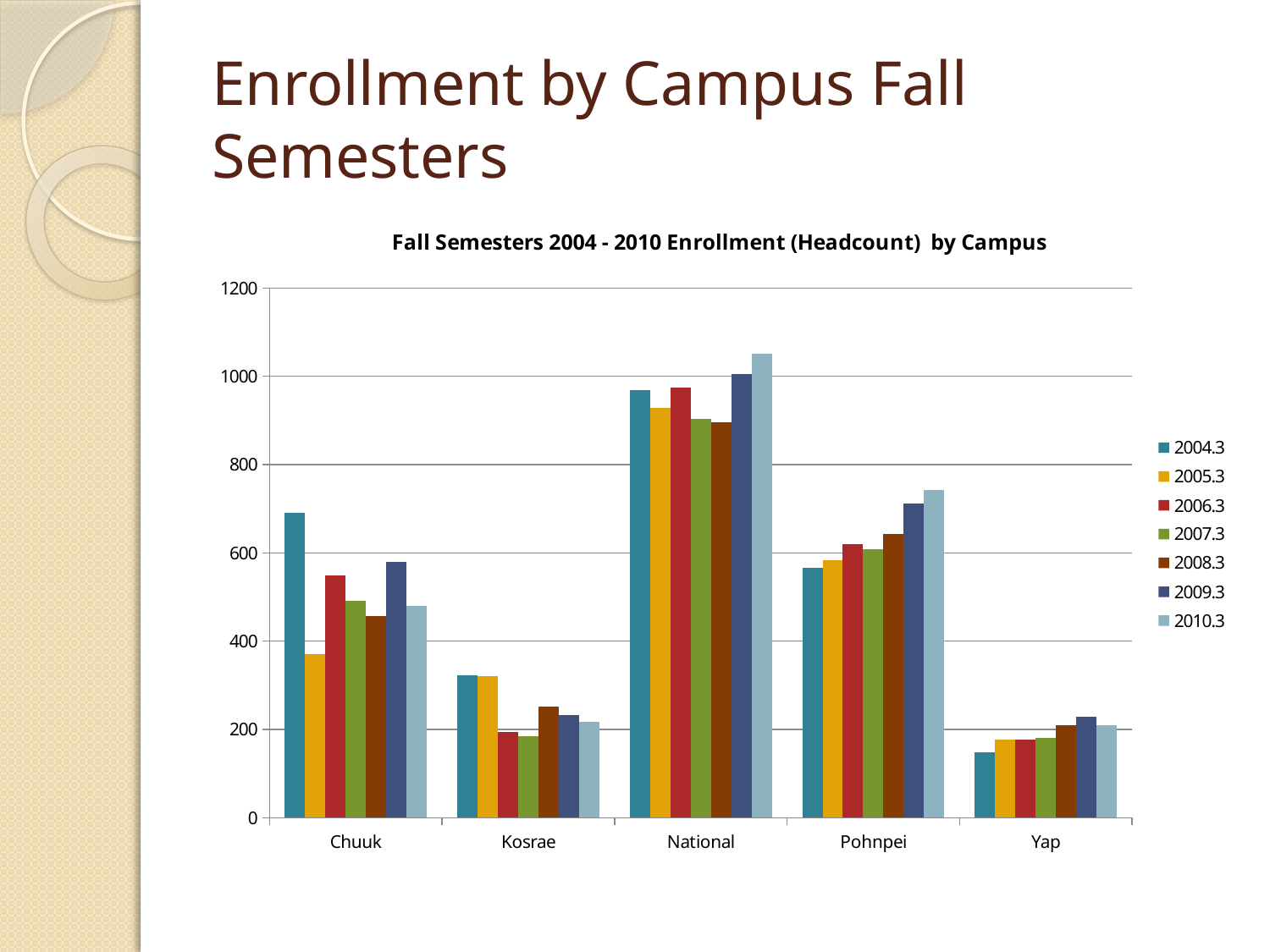
What kind of chart is shown on the slide? bar chart Is the value for Kosrae in 2007.3 greater or less than 200? less Which campus has the highest enrollment for 2010.3? National Which is larger for 2010.3: Pohnpei or Chuuk? Pohnpei How many campuses are shown on the x axis? 5 Is the value for Chuuk in 2004.3 greater or less than 600? greater How many series does the legend list? 7 Is the value for National in 2010.3 greater or less than 1000? greater What is the title of the chart? Fall Semesters 2004 - 2010 Enrollment (Headcount) by Campus Which campus has the lowest enrollment for 2004.3? Yap For Chuuk, which semester has the highest bar? 2004.3